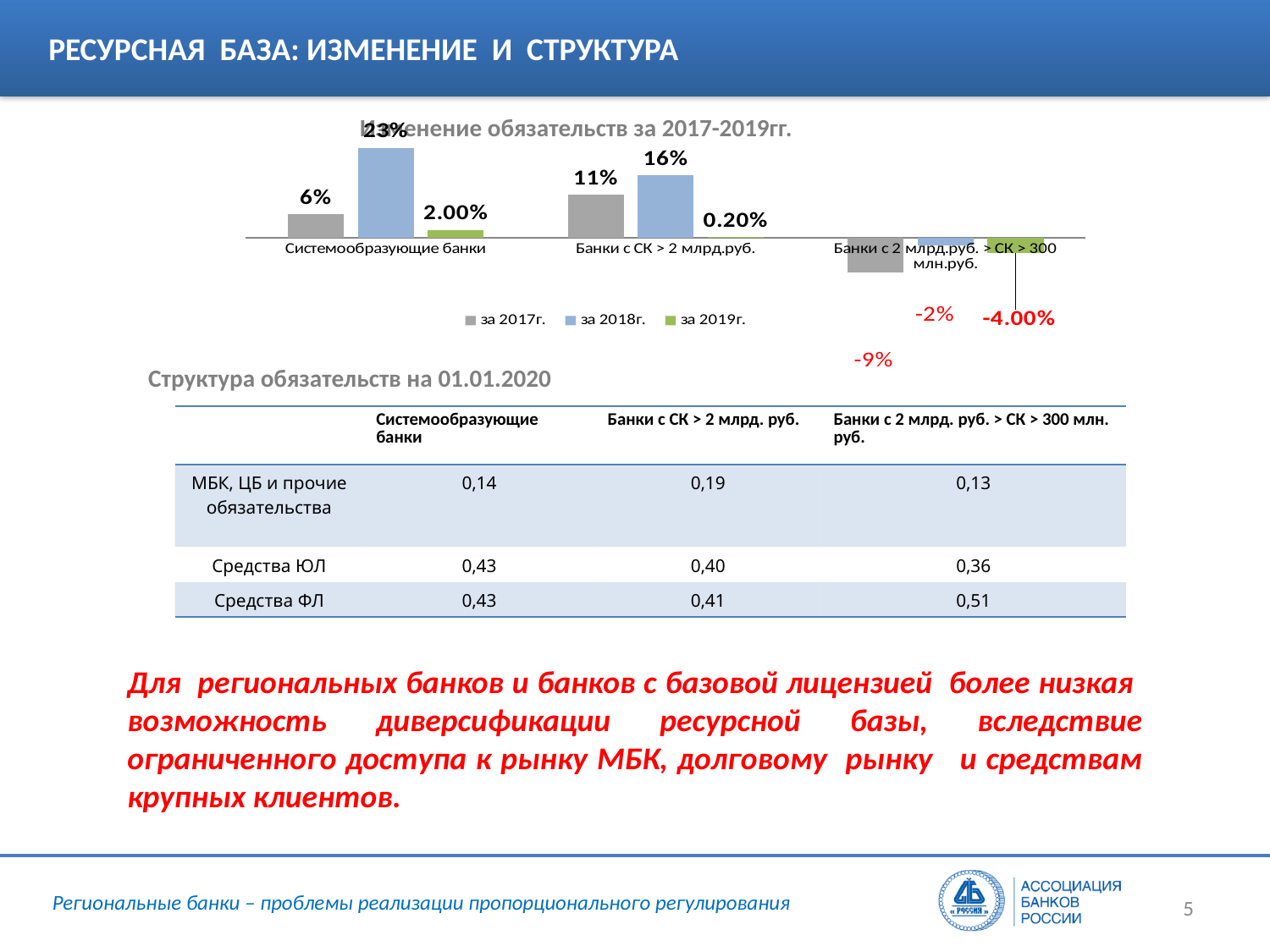
In the chart 'Изменение обязательств за 2017-2019гг.', what is the difference between the за 2018г. and за 2017г. values for Системообразующие банки? 17% In the chart 'Изменение обязательств за 2017-2019гг.', which category has the highest value for за 2018г.? Системообразующие банки How many categories are shown on the x axis of the chart 'Изменение обязательств за 2017-2019гг.'? 3 In the chart 'Изменение обязательств за 2017-2019гг.', which is larger for за 2017г.: Системообразующие банки or Банки с СК > 2 млрд.руб.? Банки с СК > 2 млрд.руб. In the chart 'Изменение обязательств за 2017-2019гг.', what is the value for Системообразующие банки for за 2018г.? 23% In the chart 'Изменение обязательств за 2017-2019гг.', what is the value for Системообразующие банки for за 2019г.? 2.00% What type of chart is 'Изменение обязательств за 2017-2019гг.'? Bar chart In the chart 'Изменение обязательств за 2017-2019гг.', which category has the lowest value for за 2017г.? Банки с 2 млрд.руб. > СК > 300 млн.руб. In the chart 'Изменение обязательств за 2017-2019гг.', what is the value for Банки с 2 млрд.руб. > СК > 300 млн.руб. for за 2017г.? -9% In the chart 'Изменение обязательств за 2017-2019гг.', what is the value for Банки с СК > 2 млрд.руб. for за 2019г.? 0.20% In the chart 'Изменение обязательств за 2017-2019гг.', what is the value for Банки с 2 млрд.руб. > СК > 300 млн.руб. for за 2018г.? -2% How many series does the legend of the chart 'Изменение обязательств за 2017-2019гг.' list? 3